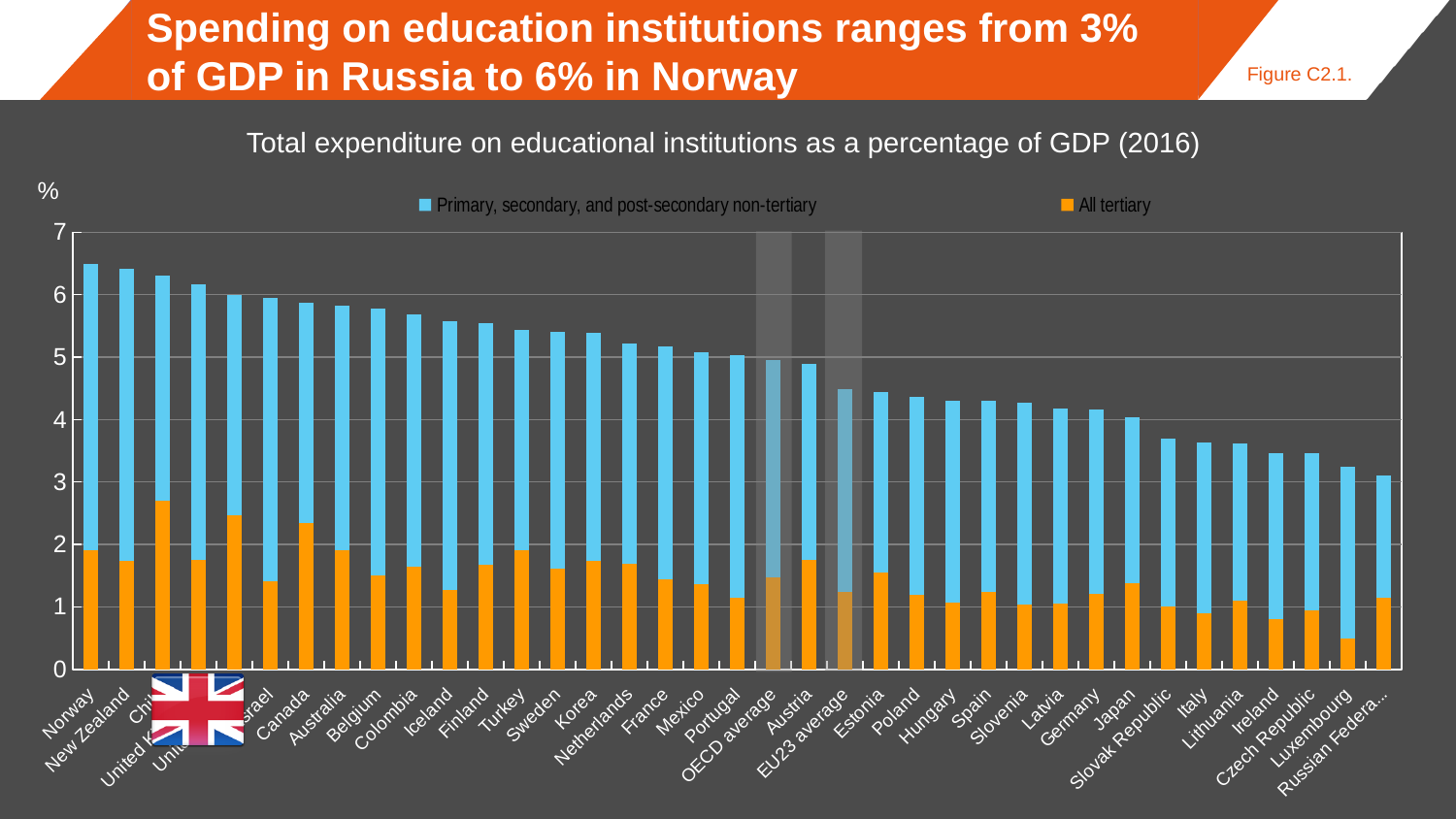
What kind of chart is shown on the slide? Stacked bar chart Is the 'All tertiary' value for Chile greater or less than 2? greater Do the total values rise or fall moving from left to right along the x axis? fall Is the 'All tertiary' value for Luxembourg greater or less than 1? less Which colour represents the 'All tertiary' series? Orange Which country has the lowest total expenditure on educational institutions as a percentage of GDP? Russian Federation Which has the larger 'All tertiary' value, Chile or Norway? Chile How many series does the legend list? 2 Is the total value for Italy greater or less than 4? less Which country has the highest total expenditure on educational institutions as a percentage of GDP? Norway